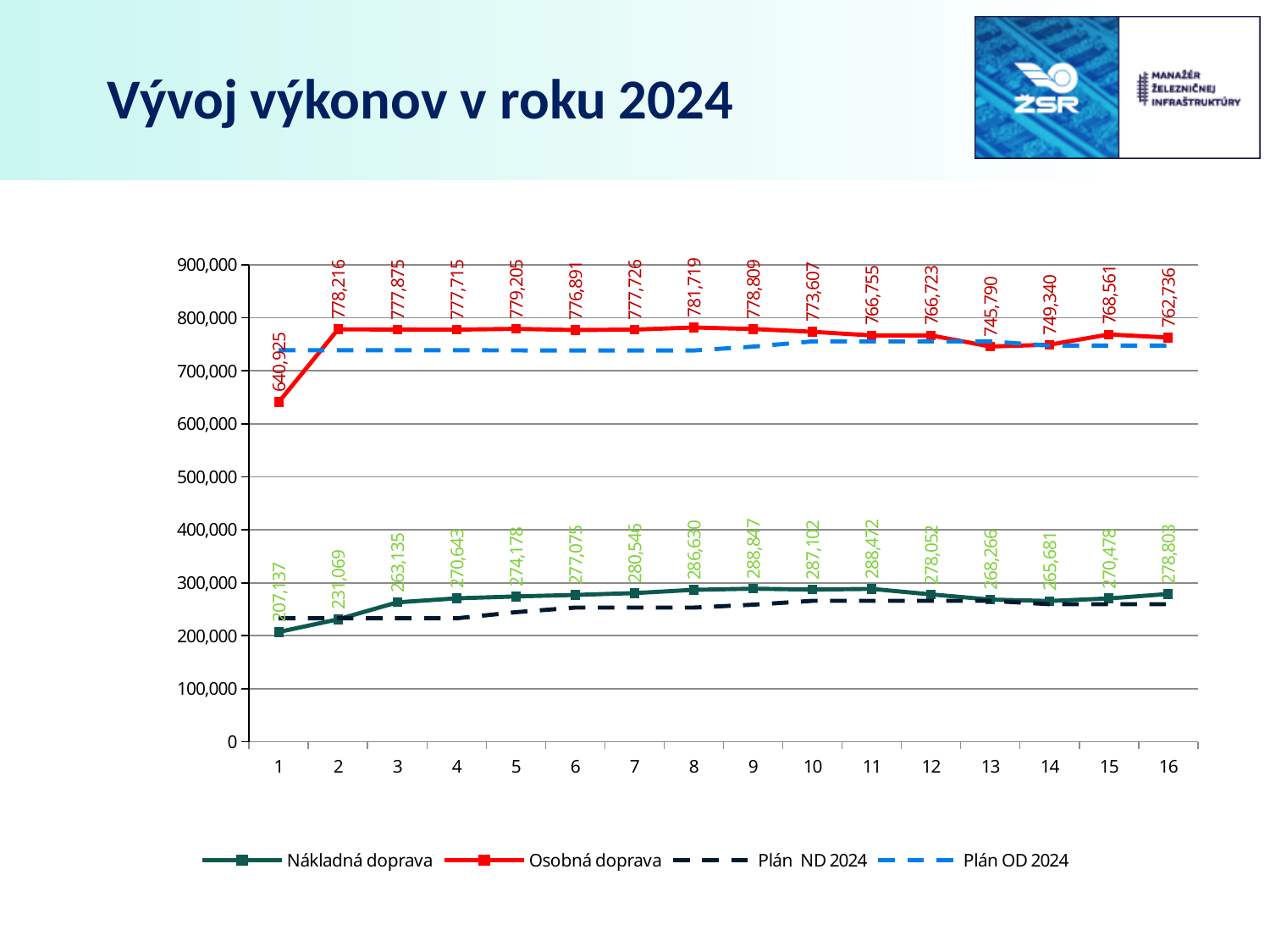
Does Nákladná doprava rise or fall from point 1 to point 9? rise How many points are plotted along the x axis for each series? 16 What is the value of Nákladná doprava at point 9? 288,847 At which point is Nákladná doprava lowest? 1 What is the value of Osobná doprava at point 13? 745,790 What type of chart is shown on the slide? line chart How many series does the legend list? 4 At which point is Osobná doprava highest? 8 What is the difference between Osobná doprava at point 2 and at point 1? 137,291 Which is larger: Nákladná doprava at point 8 or at point 14? point 8 Is the value of Plán OD 2024 at point 5 greater or less than 700,000? greater What is the value of Osobná doprava at point 1? 640,925